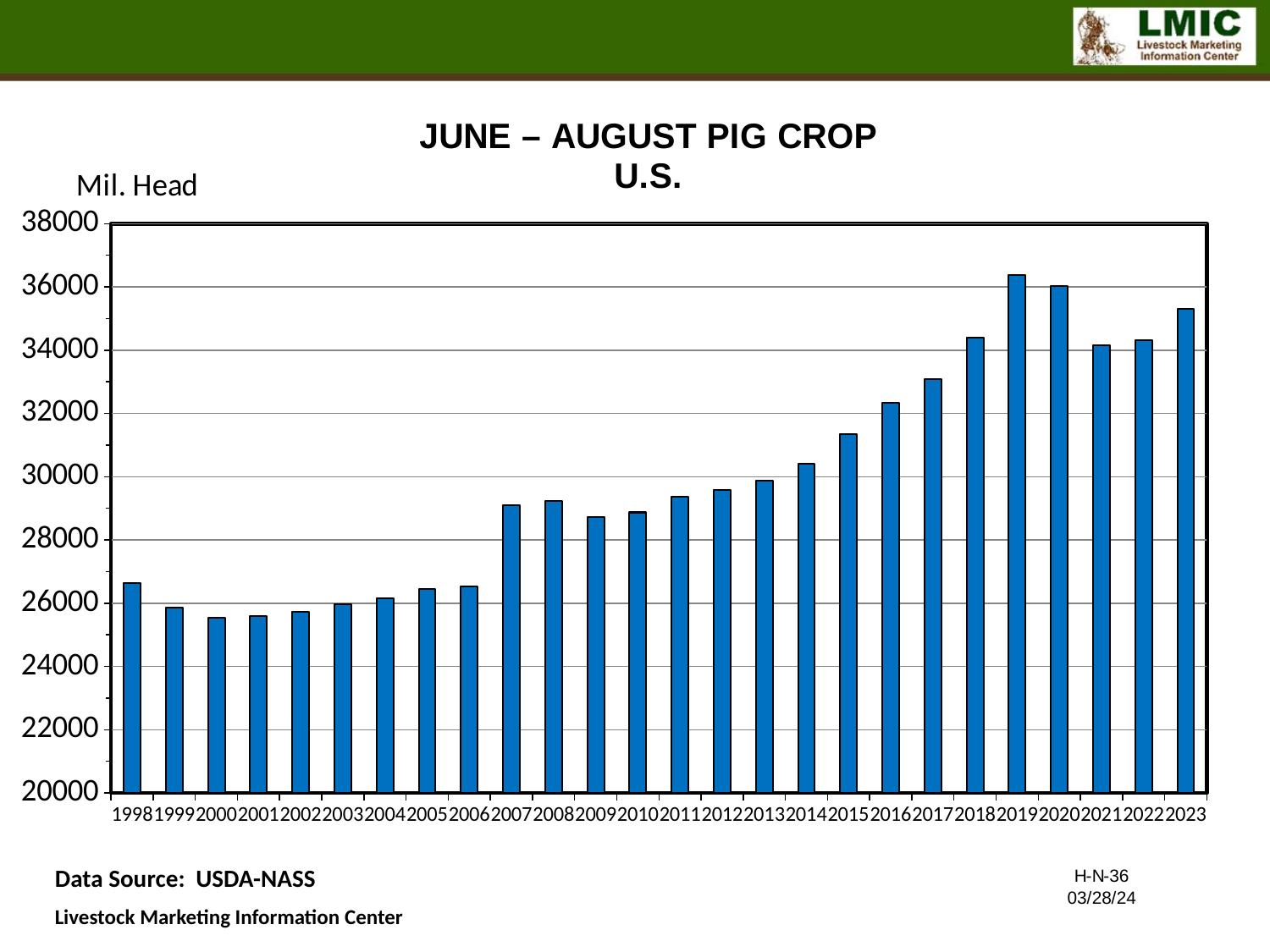
Is the value for 2023 greater or less than 34000? greater Do the values generally rise or fall from 1998 to 2023? rise Which year has the highest June–August pig crop? 2019 Which is larger, the value for 1998 or the value for 1999? 1998 What is the title of the chart? JUNE – AUGUST PIG CROP U.S. Is the value for 2000 greater or less than 26000? less Which is larger, the value for 2019 or the value for 2020? 2019 How many years (bars) are plotted in the chart? 26 Is the value for 2009 greater or less than 30000? less What unit is shown on the vertical axis label? Mil. Head What kind of chart is shown on the slide? bar chart